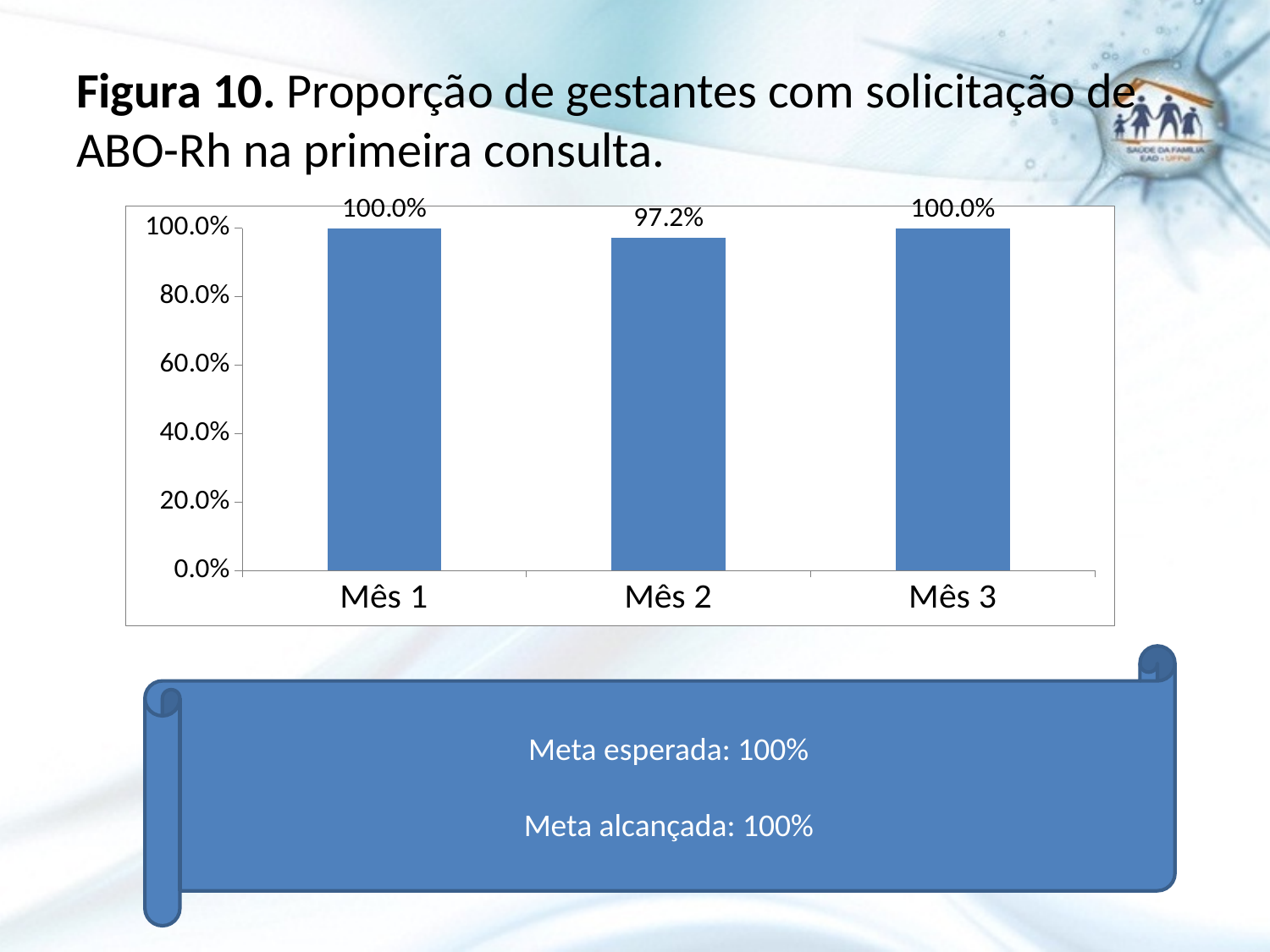
What is the difference between the values for Mês 1 and Mês 2? 2.8% What is the highest tick value shown on the y axis? 100.0% How many categories are shown on the x axis? 3 What colour are the bars in the chart? blue What is the value for Mês 3? 100.0% Which month has the lowest value? Mês 2 What is the value for Mês 1? 100.0% What kind of chart is shown on the slide? bar chart What is the value for Mês 2? 97.2% Which is larger, the value for Mês 2 or the value for Mês 3? Mês 3 Is the value for Mês 2 greater or less than 80.0%? greater Do the values rise or fall from Mês 1 to Mês 2? fall